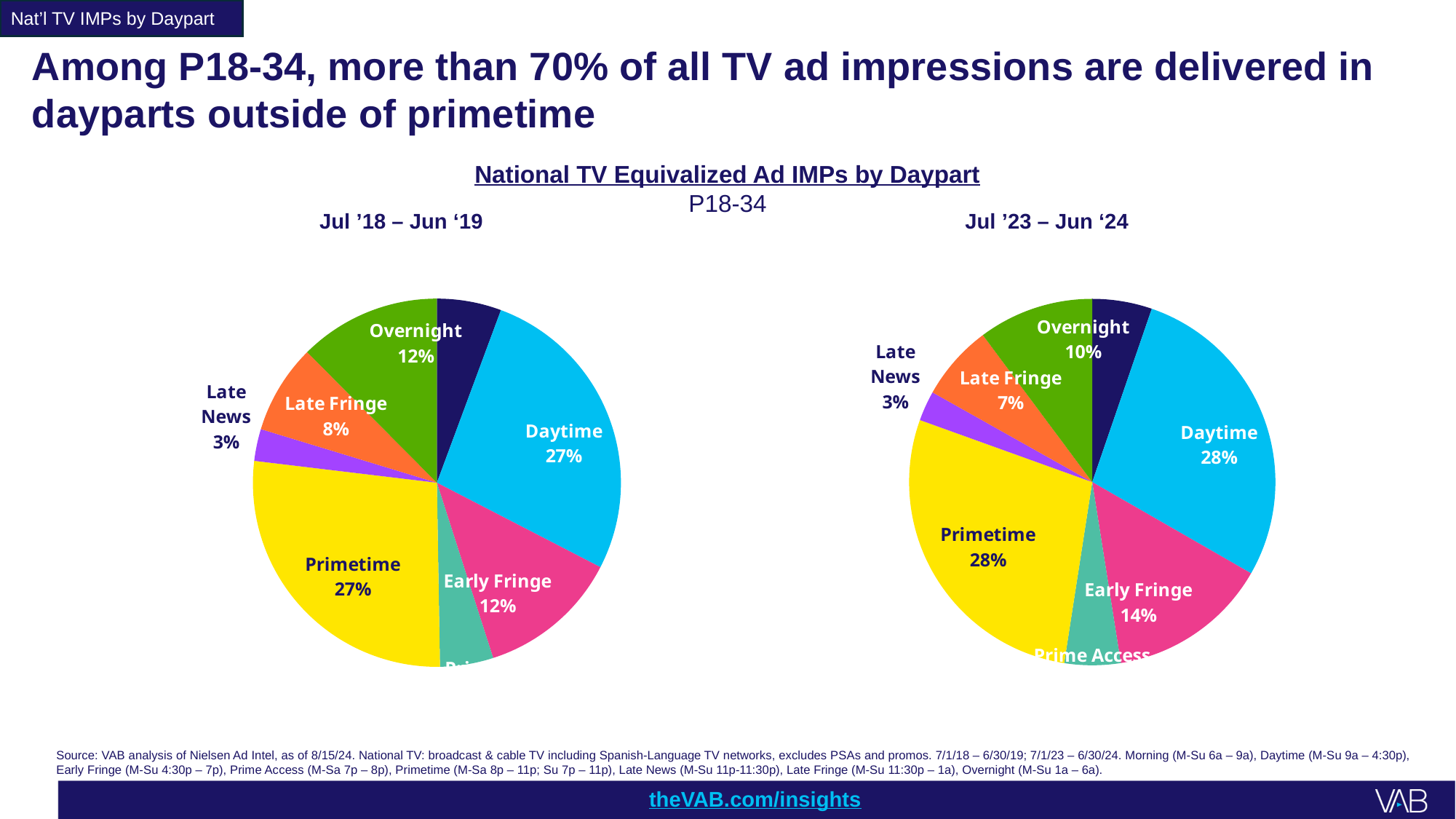
In the Jul '23 – Jun '24 pie chart, what is the value for Late Fringe? 7% How many slices does the Jul '18 – Jun '19 pie chart have? 8 In the Jul '18 – Jun '19 pie chart, what is the value for Late News? 3% What type of chart is used to show the Jul '23 – Jun '24 data? Pie chart By how many percentage points does Early Fringe in the Jul '23 – Jun '24 chart exceed Early Fringe in the Jul '18 – Jun '19 chart? 2 percentage points In the Jul '23 – Jun '24 pie chart, what is the value for Primetime? 28% Which is larger: Overnight in the Jul '18 – Jun '19 chart or Overnight in the Jul '23 – Jun '24 chart? Jul '18 – Jun '19 In the Jul '18 – Jun '19 pie chart, what share of ad impressions does Daytime account for? 27% In the Jul '23 – Jun '24 pie chart, what is the value for Early Fringe? 14% In the Jul '18 – Jun '19 pie chart, what is the value for Overnight? 12% What is the title shown above the two pie charts? National TV Equivalized Ad IMPs by Daypart In the Jul '18 – Jun '19 pie chart, which is larger: Late Fringe or Late News? Late Fringe